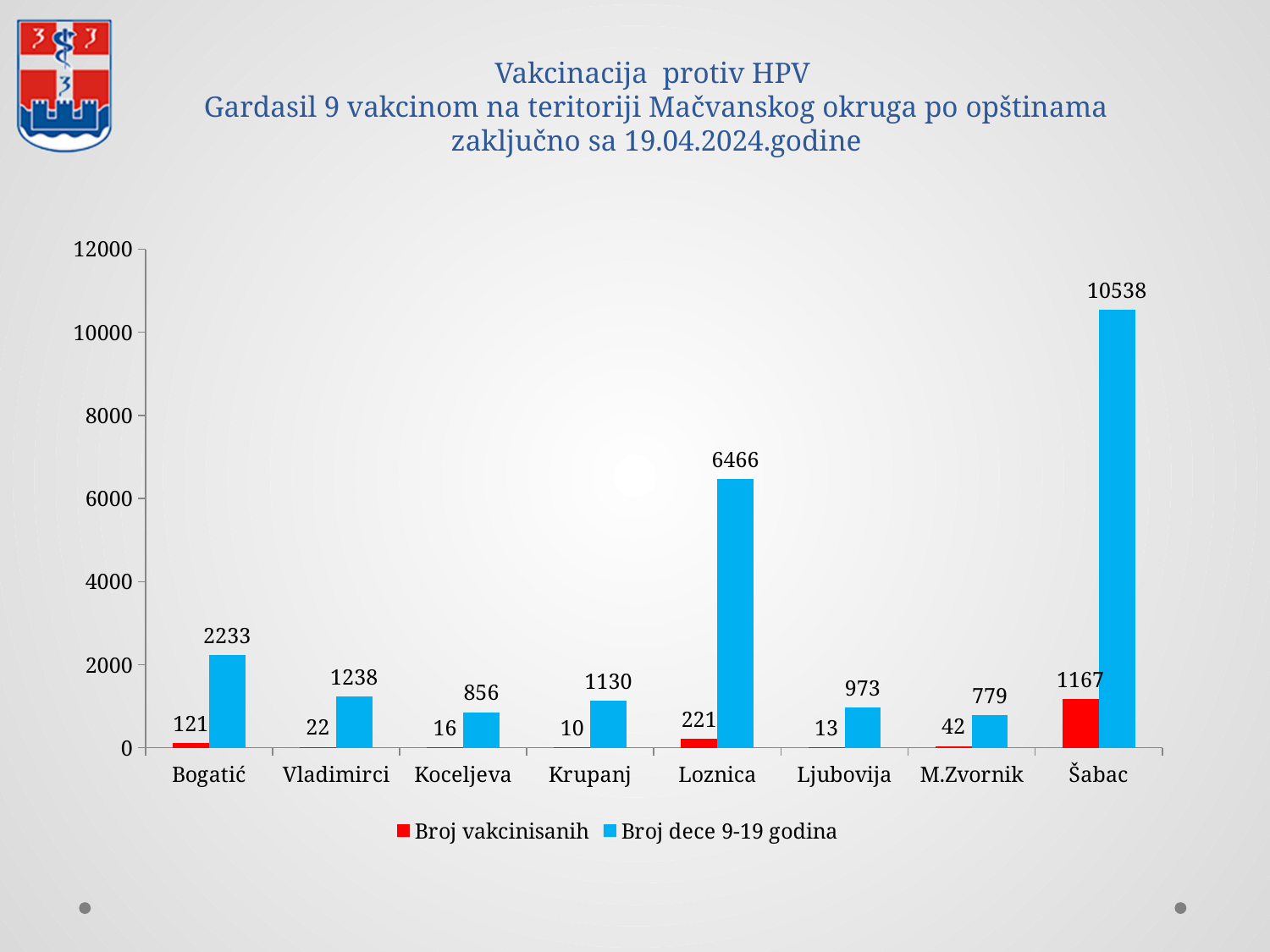
What is the value of 'Broj dece 9-19 godina' for Loznica? 6466 How many municipalities are shown on the x axis? 8 Is the value of 'Broj dece 9-19 godina' for Šabac greater or less than 10000? greater How many series does the legend list? 2 Which municipality has the highest value for 'Broj dece 9-19 godina'? Šabac Which municipality has the lowest value for 'Broj dece 9-19 godina'? M.Zvornik Which municipality has the lowest value for 'Broj vakcinisanih'? Krupanj What kind of chart is shown on the slide? Bar chart Which is larger: 'Broj dece 9-19 godina' for Vladimirci or for Krupanj? Vladimirci What is the value of 'Broj vakcinisanih' for Krupanj? 10 What is the value of 'Broj vakcinisanih' for Šabac? 1167 What is the difference between 'Broj dece 9-19 godina' and 'Broj vakcinisanih' for Bogatić? 2112